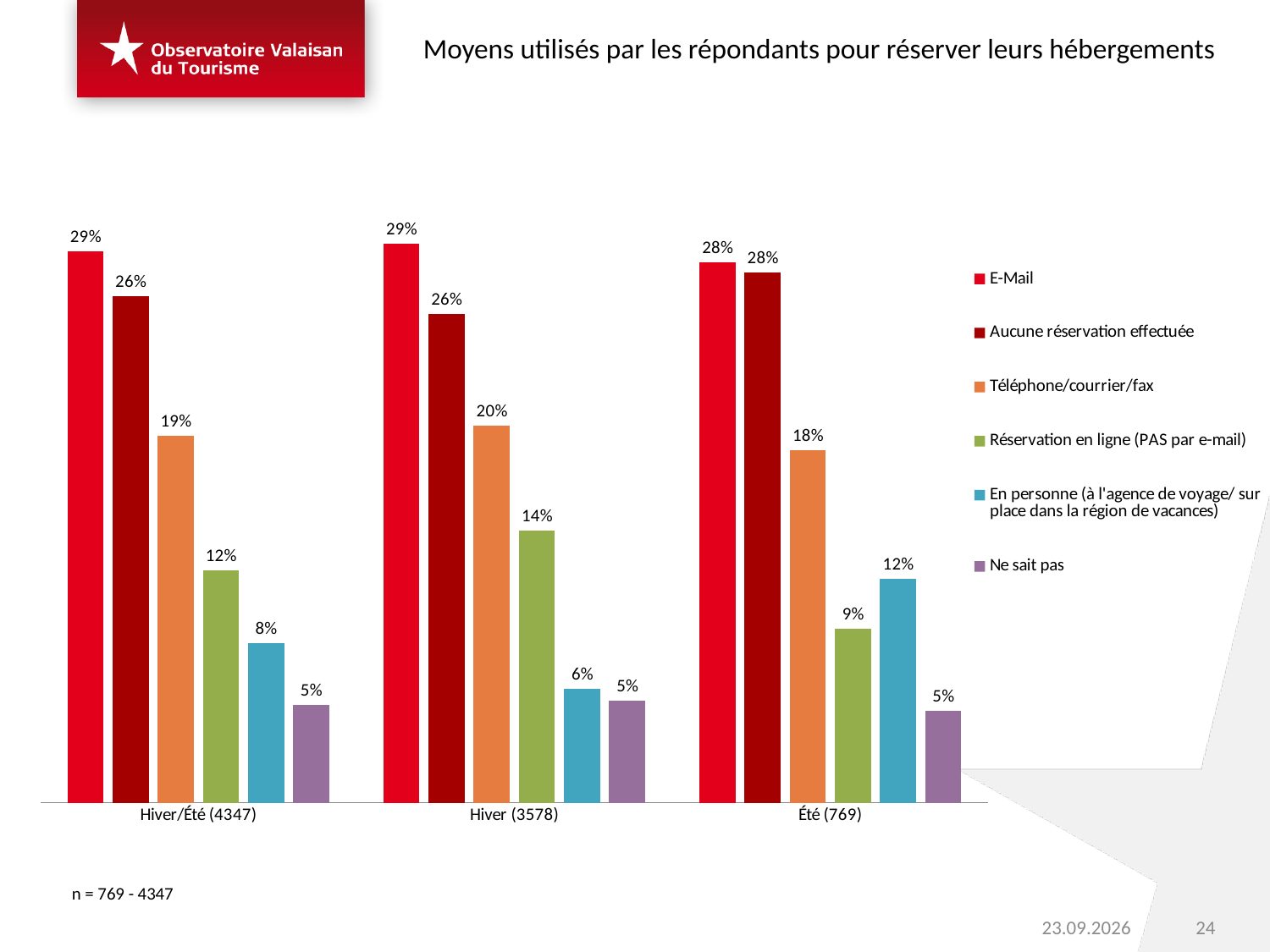
How many series does the legend list? 6 What is the value for E-Mail in the Hiver (3578) group? 29% What kind of chart is shown on the slide? Bar chart How many category groups are shown on the x axis? 3 What is the value for Téléphone/courrier/fax in the Été (769) group? 18% What is the difference between Aucune réservation effectuée and Réservation en ligne (PAS par e-mail) in the Hiver (3578) group? 12% What is the title of the chart? Moyens utilisés par les répondants pour réserver leurs hébergements Which is larger in the Été (769) group: Réservation en ligne (PAS par e-mail) or En personne (à l'agence de voyage/ sur place dans la région de vacances)? En personne (à l'agence de voyage/ sur place dans la région de vacances) What is the value for En personne (à l'agence de voyage/ sur place dans la région de vacances) in the Hiver/Été (4347) group? 8% Which series has the lowest value in the Hiver (3578) group? Ne sait pas Which series has the highest value in the Hiver/Été (4347) group? E-Mail What is the difference between Téléphone/courrier/fax in the Hiver (3578) group and in the Été (769) group? 2%